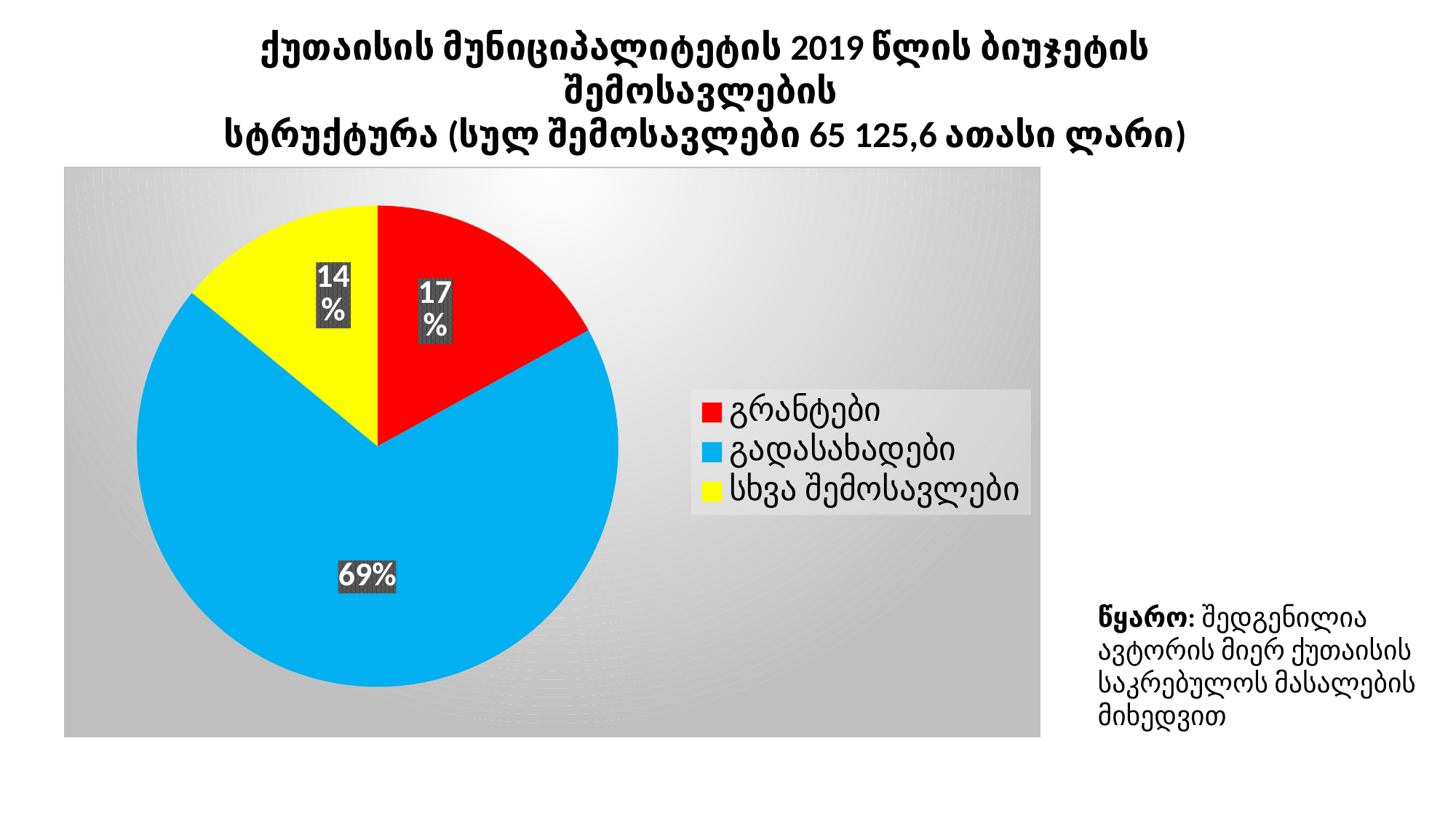
Which is larger, the share for გრანტები or the share for სხვა შემოსავლები? გრანტები How many slices does the pie chart have? 3 What share of the pie does გრანტები represent? 17% What type of chart is shown on the slide? pie chart How many entries does the legend list? 3 What colour is the slice for გადასახადები? blue What total revenue figure is given in the chart title? 65 125,6 ათასი ლარი What is the difference in percentage points between გადასახადები and გრანტები? 52 What share of the pie does გადასახადები represent? 69% Which category has the smallest slice of the pie? სხვა შემოსავლები Which category has the largest slice of the pie? გადასახადები What share of the pie does სხვა შემოსავლები represent? 14%